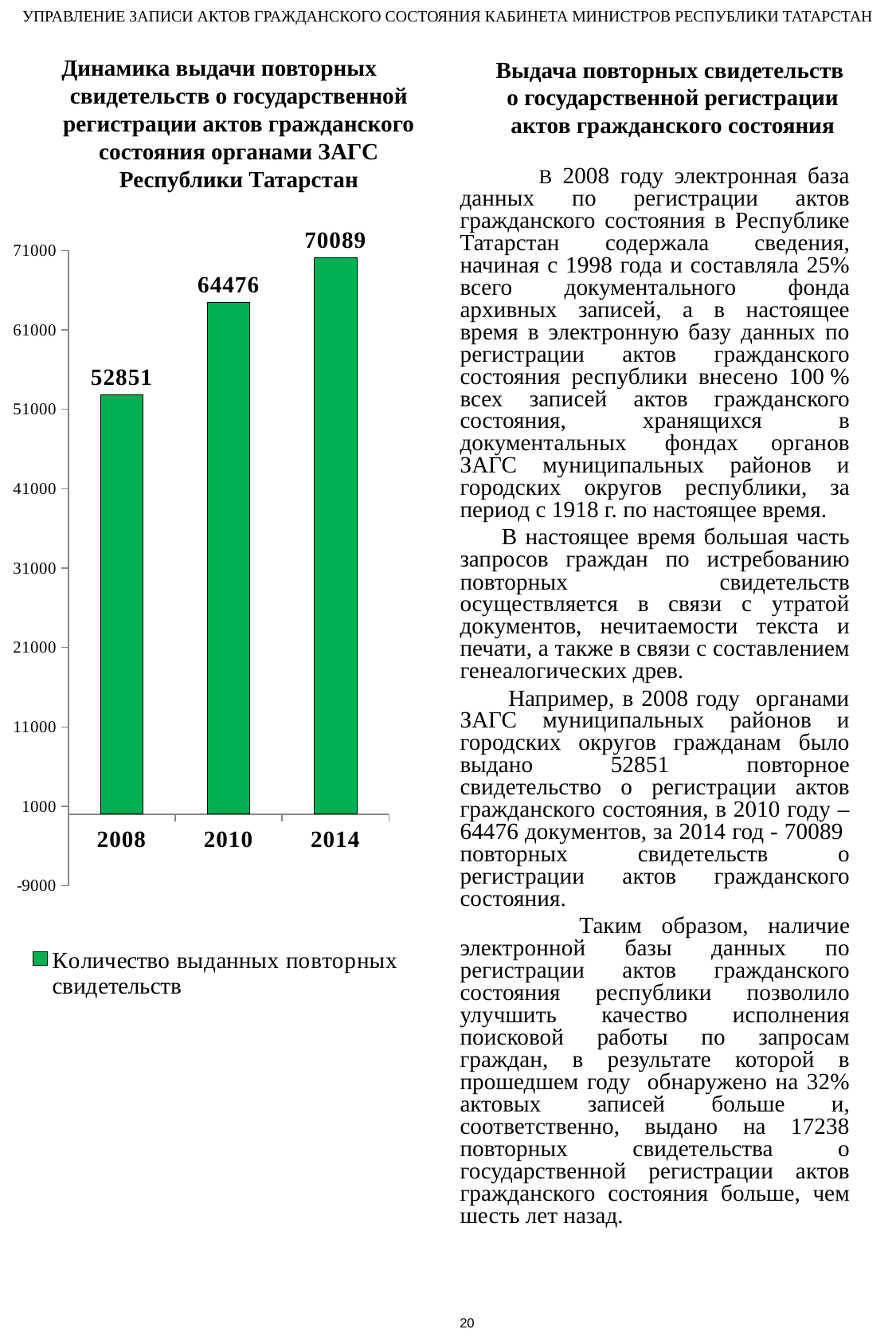
Which year has the highest value in the chart? 2014 What is the difference between the values for 2014 and 2008? 17238 Which is larger, the value for 2010 or the value for 2014? 2014 Which year has the lowest value in the chart? 2008 Is the value for 2008 greater or less than 61000? less How many years (bars) are shown in the chart? 3 What is the value for 2008 in the chart? 52851 What kind of chart is shown on the slide? bar chart Do the values rise or fall from 2008 to 2014? rise What is the difference between the values for 2010 and 2008? 11625 What is the value for 2010 in the chart? 64476 What is the value for 2014 in the chart? 70089